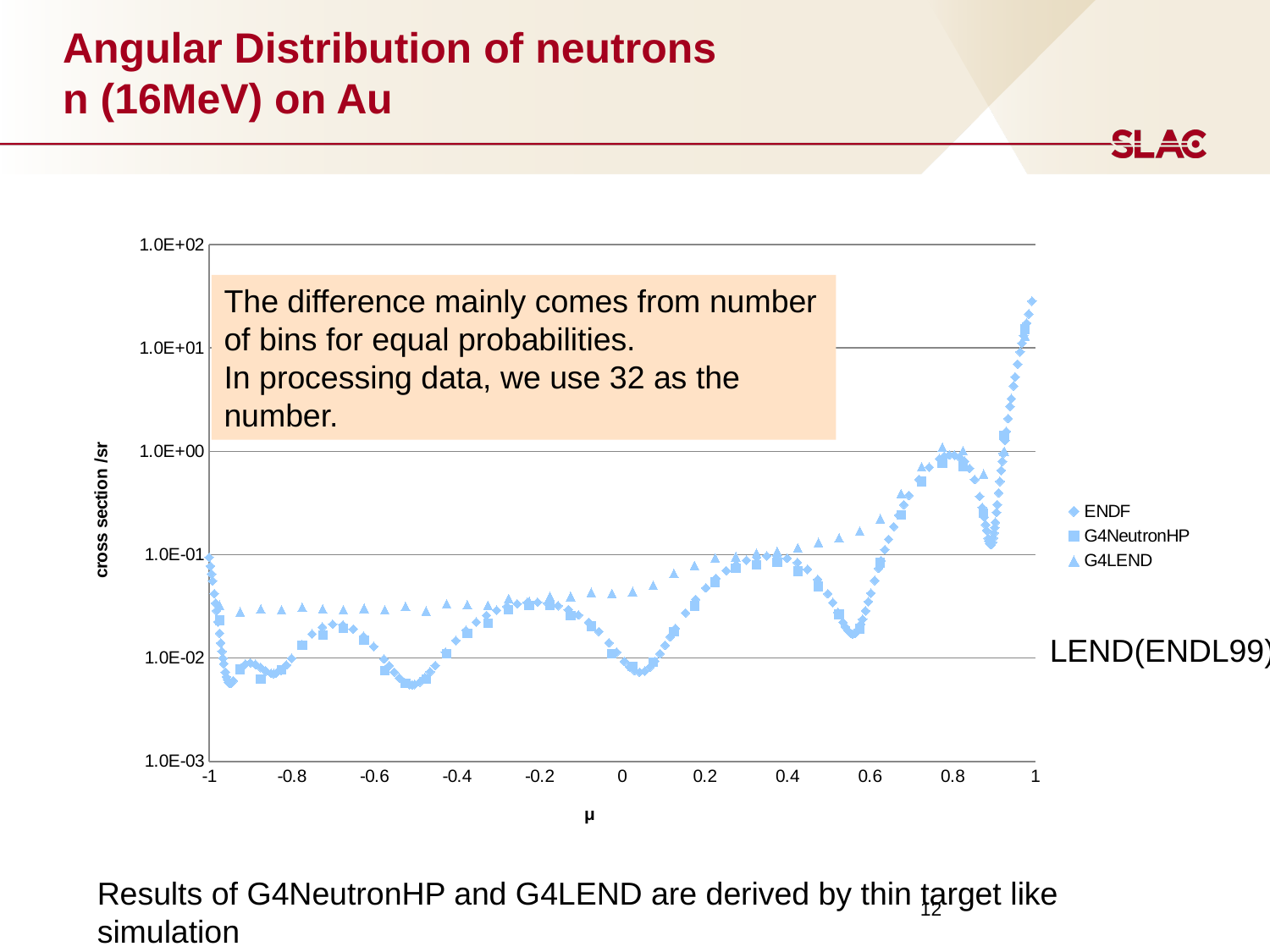
Is the ENDF value at μ = 1 greater or less than 1.0E+01? greater Is the ENDF value at μ = 0.8 greater or less than 1.0E-01? greater What is the label of the vertical axis of the chart? cross section /sr Is the ENDF value at μ = -0.5 greater or less than 1.0E-02? less How many series does the chart legend list? 3 What are the three series named in the chart legend? ENDF, G4NeutronHP, G4LEND At μ = -0.6, which series has the larger value, G4LEND or ENDF? G4LEND What kind of chart is shown on the slide? scatter chart Overall, do the plotted cross section values rise or fall as μ goes from -1 to 1? rise